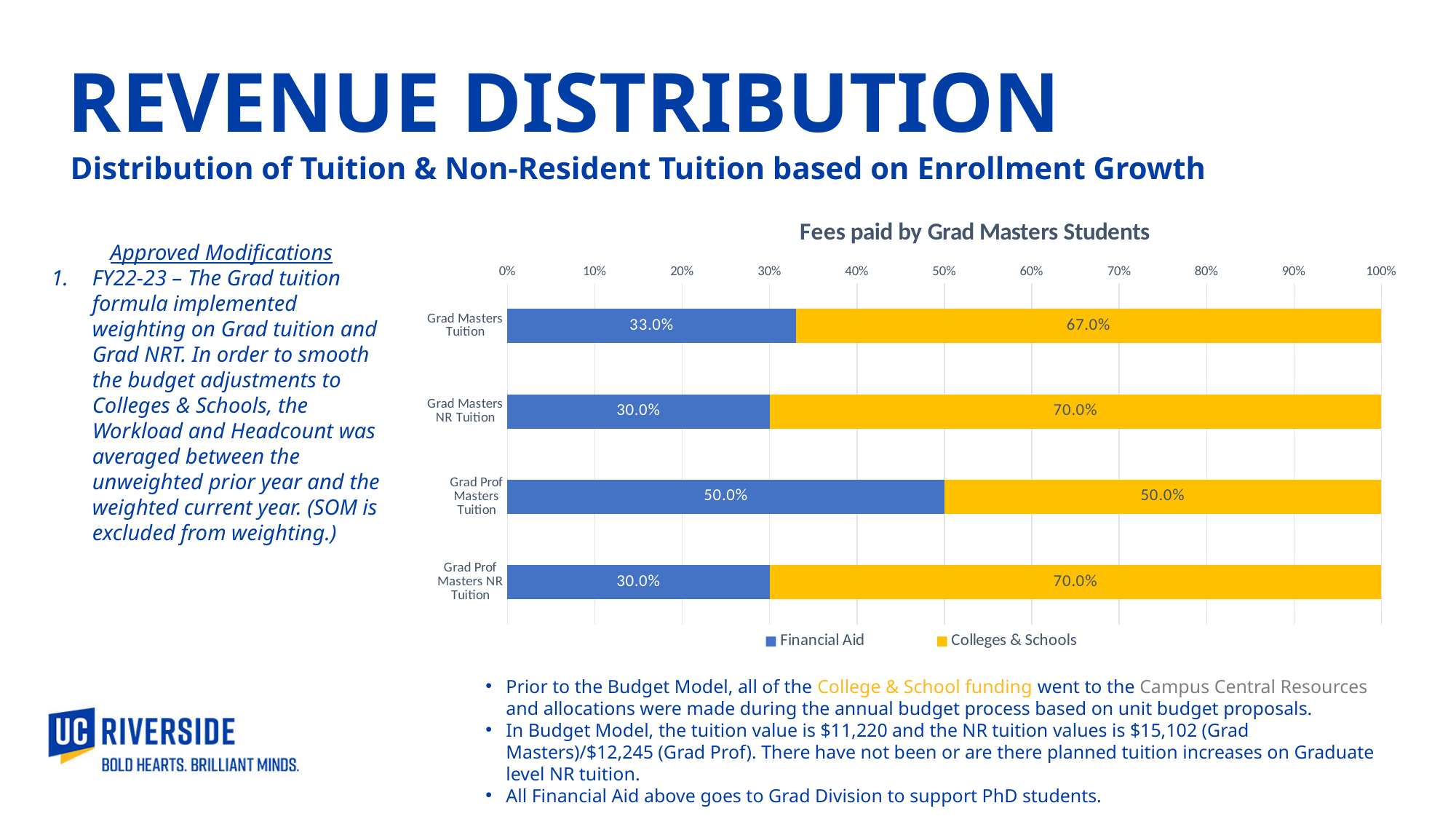
What is the Colleges & Schools share for Grad Masters NR Tuition? 70.0% What kind of chart is shown? Stacked bar chart How many categories are shown on the chart? 4 Is the Financial Aid share larger for Grad Masters Tuition or for Grad Masters NR Tuition? Grad Masters Tuition How many series does the legend list? 2 Which category has the lowest Colleges & Schools share? Grad Prof Masters Tuition What is the Colleges & Schools share for Grad Prof Masters NR Tuition? 70.0% What is the Financial Aid share for Grad Masters Tuition? 33.0% What is the title of the chart? Fees paid by Grad Masters Students What is the difference between the Colleges & Schools share and the Financial Aid share for Grad Masters Tuition? 34.0% Which category has the highest Financial Aid share? Grad Prof Masters Tuition What is the Financial Aid share for Grad Prof Masters Tuition? 50.0%